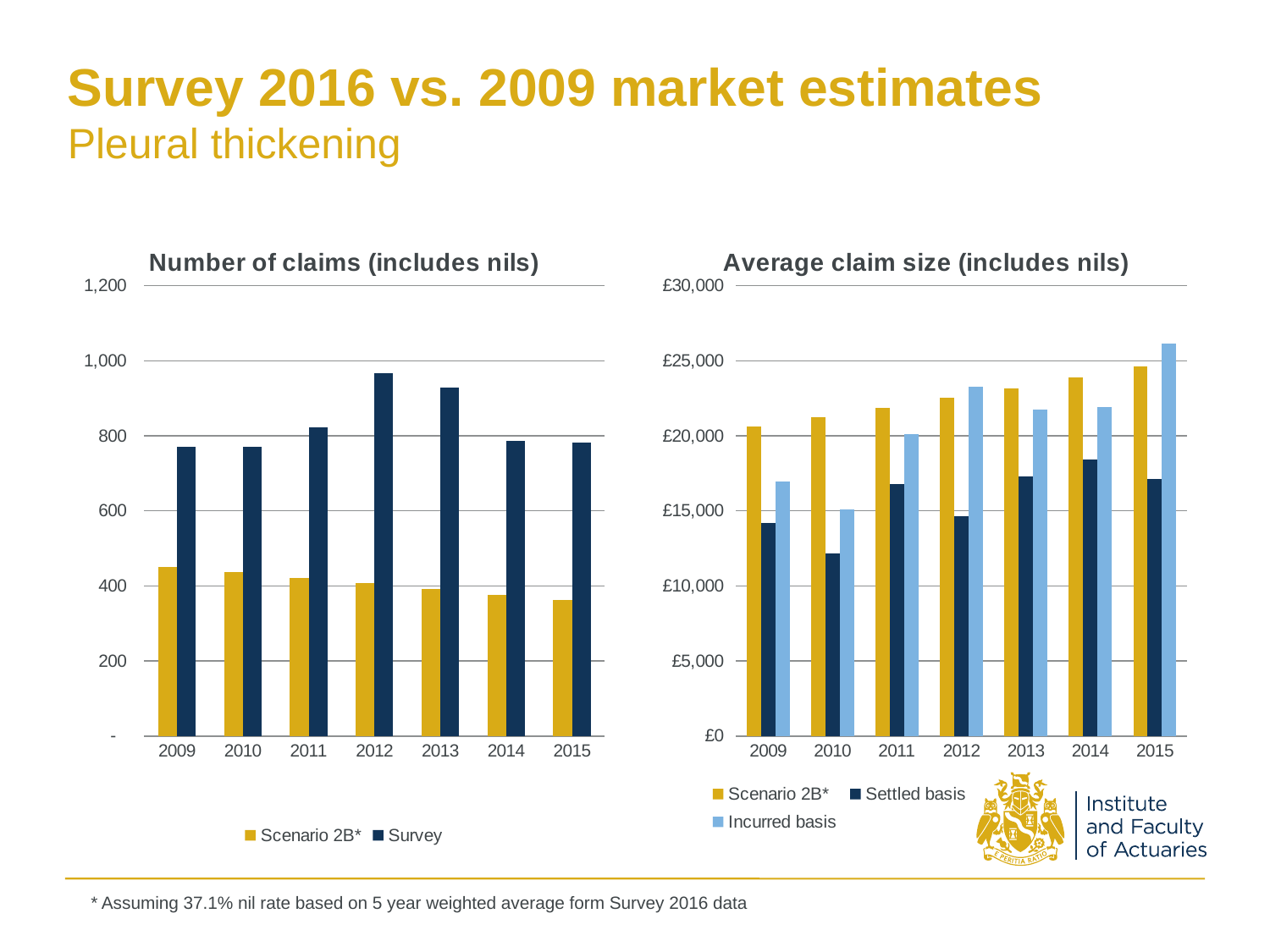
In the 'Number of claims (includes nils)' chart, is the Scenario 2B* value for 2015 greater or less than 400? less In the 'Number of claims (includes nils)' chart, which year has the highest Survey value? 2012 In the 'Number of claims (includes nils)' chart, how many series does the legend list? 2 In the 'Average claim size (includes nils)' chart, which is larger for 2009: Scenario 2B* or Settled basis? Scenario 2B* What kind of chart is the 'Number of claims (includes nils)' chart? Bar chart In the 'Number of claims (includes nils)' chart, how many years are shown on the x axis? 7 In the 'Average claim size (includes nils)' chart, how many series does the legend list? 3 In the 'Average claim size (includes nils)' chart, do the Scenario 2B* values rise or fall from 2009 to 2015? Rise In the 'Average claim size (includes nils)' chart, which year has the lowest Settled basis value? 2010 In the 'Number of claims (includes nils)' chart, is the Survey value for 2012 greater or less than 800? greater In the 'Number of claims (includes nils)' chart, do the Scenario 2B* values rise or fall from 2009 to 2015? Fall In the 'Average claim size (includes nils)' chart, which year has the highest Incurred basis value? 2015